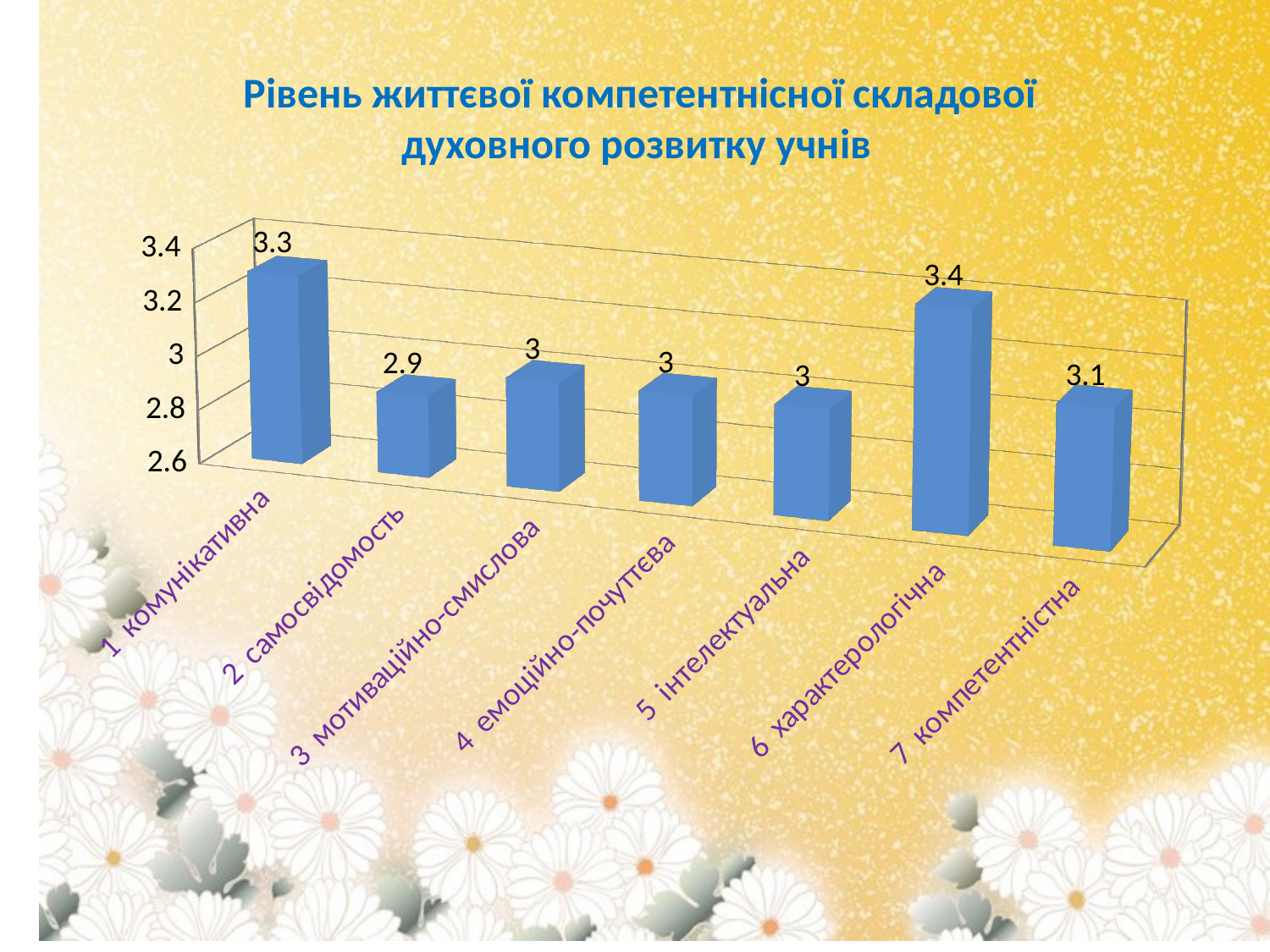
What is the value for 7 компетентністна? 3.1 What is the difference between the values for 6 характерологічна and 2 самосвідомость? 0.5 Which category has the highest value? 6 характерологічна How many categories are shown in the chart? 7 What is the title of the chart? Рівень життєвої компетентнісної складової духовного розвитку учнів Which category has the lowest value? 2 самосвідомость What is the value for 6 характерологічна? 3.4 What is the value for 2 самосвідомость? 2.9 What is the value for 1 комунікативна? 3.3 Which is larger, the value for 1 комунікативна or the value for 7 компетентністна? 1 комунікативна What kind of chart is shown on the slide? bar chart How many categories have a value of exactly 3? 3